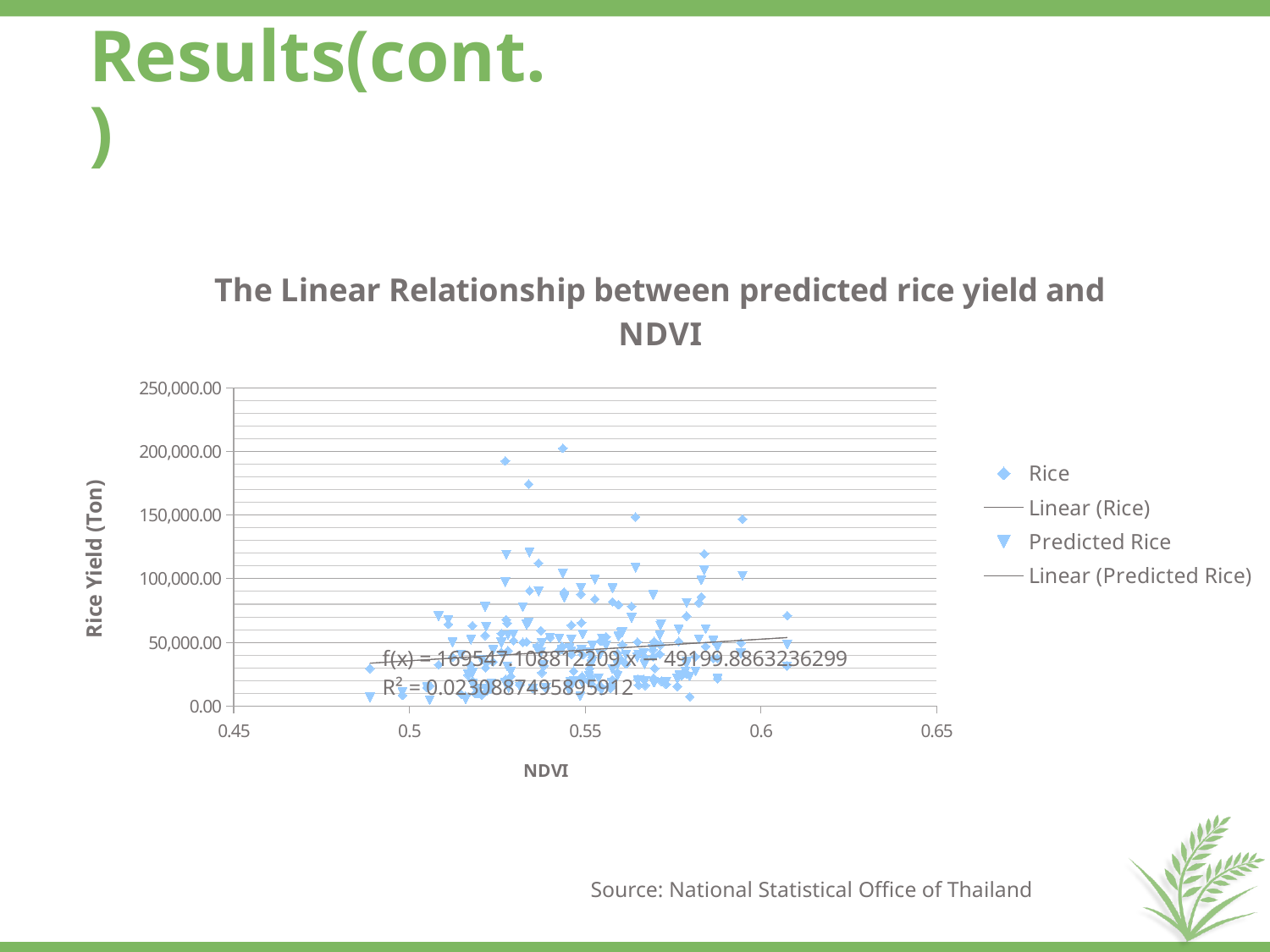
What fitted equation f(x) is printed on the chart? f(x) = 169547.108812209 x − 49199.8863236299 What kind of chart is shown on the slide? Scatter chart What is the maximum value shown on the vertical axis? 250,000.00 What is the minimum value shown on the horizontal NDVI axis? 0.45 How many entries does the chart legend list? 4 What R² value is printed on the chart? R² = 0.0230887495895912 What is the title of the chart? The Linear Relationship between predicted rice yield and NDVI Are all plotted rice yield values greater or less than 250,000.00? less Is the highest plotted rice yield value greater or less than 150,000.00? greater Is the lowest plotted rice yield value greater or less than 50,000.00? less Does the fitted trend line rise or fall as NDVI increases? Rises What is the label of the vertical axis? Rice Yield (Ton)